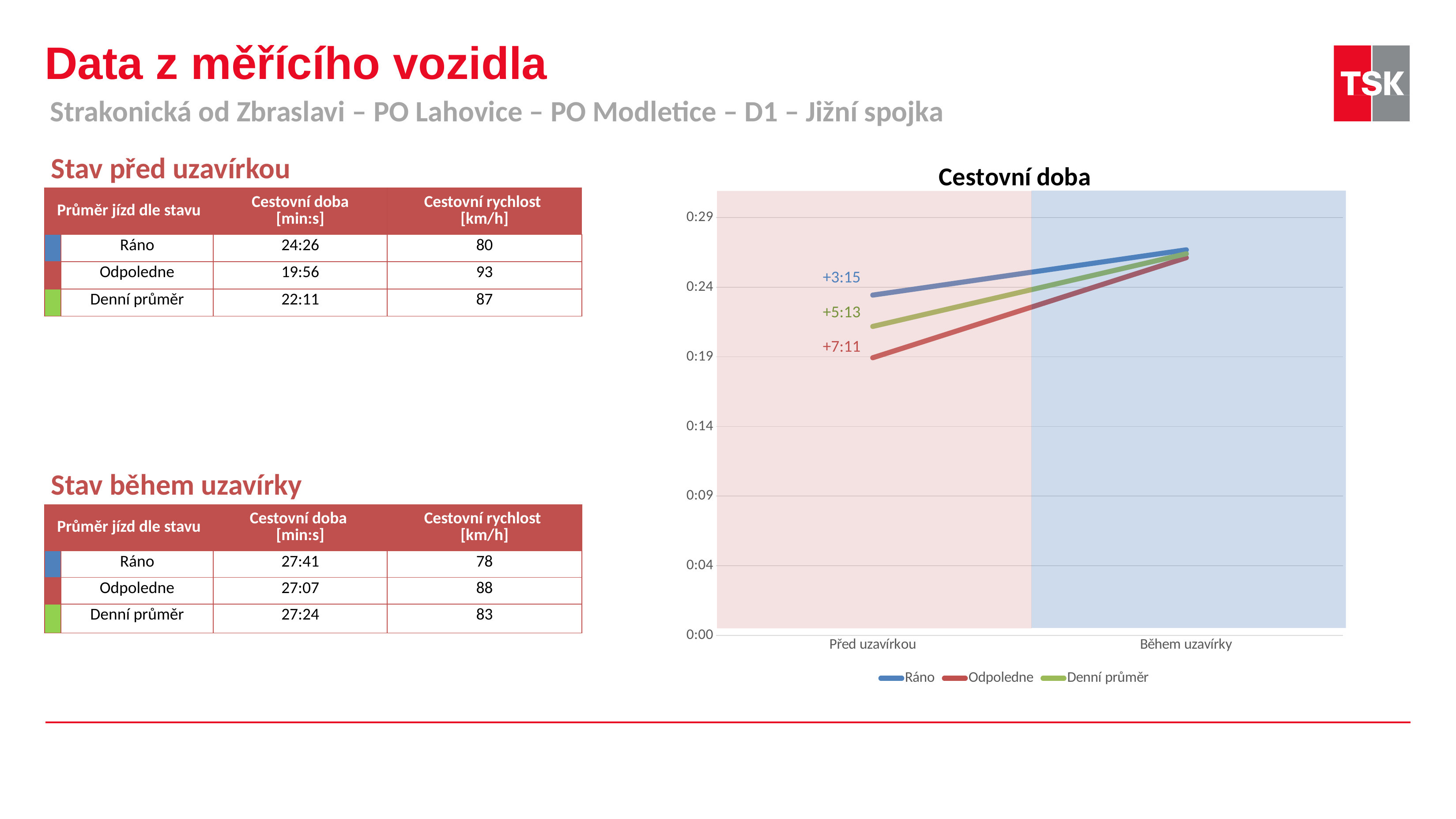
In the "Cestovní doba" chart, is the Odpoledne value at Před uzavírkou greater or less than 0:24? less In the "Cestovní doba" chart, what increase is labelled on the Odpoledne line? +7:11 How many series does the legend of the "Cestovní doba" chart list? 3 What kind of chart is the "Cestovní doba" chart? line chart In the "Cestovní doba" chart, do the lines rise or fall from Před uzavírkou to Během uzavírky? rise In the "Cestovní doba" chart, what increase is labelled on the Ráno line? +3:15 In the "Cestovní doba" chart, which series has the lowest value at Před uzavírkou? Odpoledne In the "Cestovní doba" chart, which series shows the largest increase between Před uzavírkou and Během uzavírky? Odpoledne In the "Cestovní doba" chart, which series shows the smallest increase between Před uzavírkou and Během uzavírky? Ráno How many categories are on the x axis of the "Cestovní doba" chart? 2 In the "Cestovní doba" chart, what increase is labelled on the Denní průměr line? +5:13 What is the title of the chart on the slide? Cestovní doba